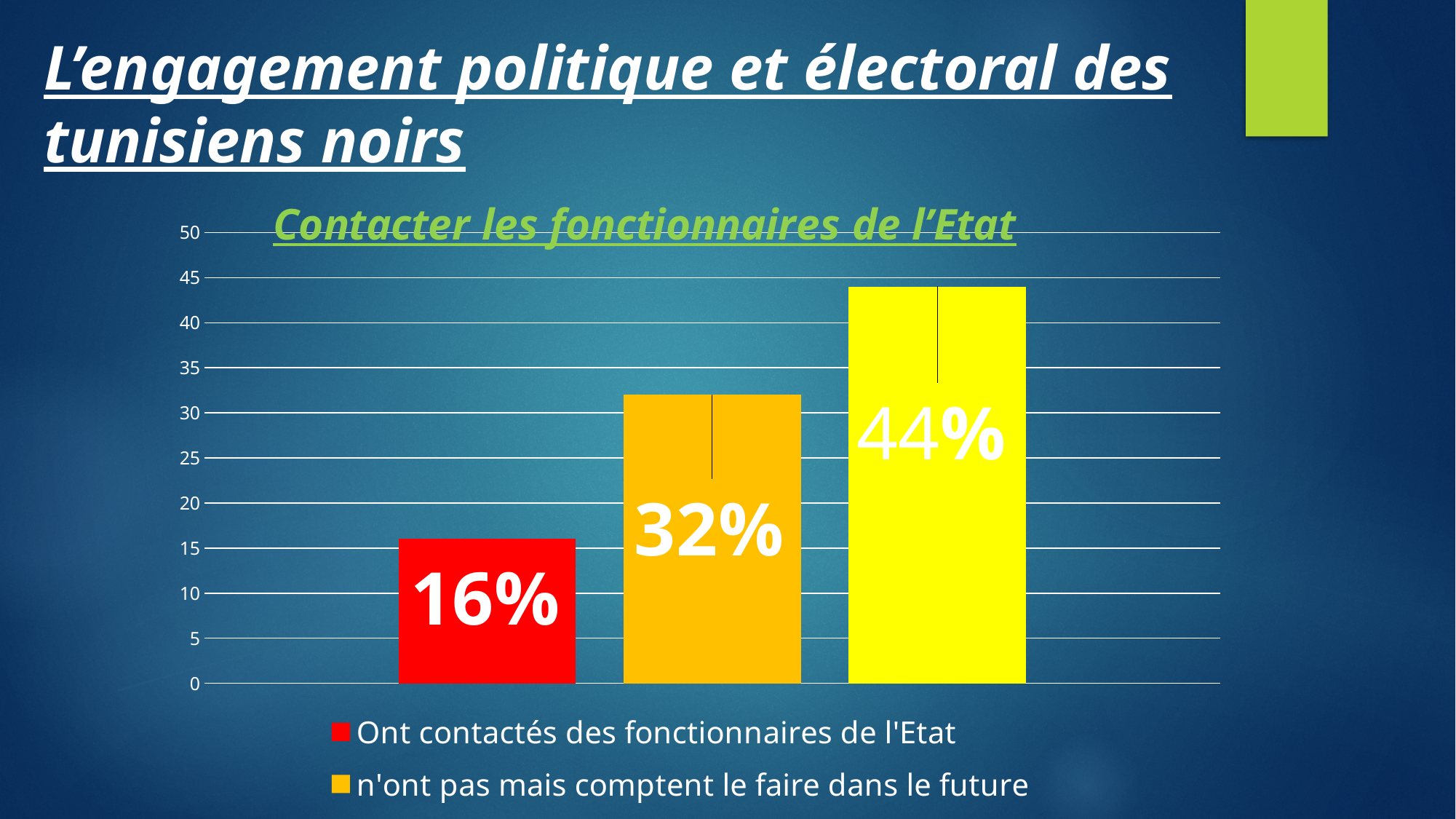
What is the difference between the value for "n'ont pas mais comptent le faire dans le future" and the value for "Ont contactés des fonctionnaires de l'Etat"? 16% Which is larger: the value for "Ont contactés des fonctionnaires de l'Etat" or the value for "n'ont pas mais comptent le faire dans le future"? n'ont pas mais comptent le faire dans le future What is the value for "Ont contactés des fonctionnaires de l'Etat"? 16% What is the title of the chart? Contacter les fonctionnaires de l'Etat What is the difference between the yellow bar's value and the orange bar's value? 12% How many entries does the legend list? 2 Which bar has the highest value? the yellow bar (44%) How many bars are plotted in the chart? 3 Which bar has the lowest value? Ont contactés des fonctionnaires de l'Etat (16%) What value is shown on the yellow bar? 44% What kind of chart is shown on the slide? bar chart What is the value for "n'ont pas mais comptent le faire dans le future"? 32%